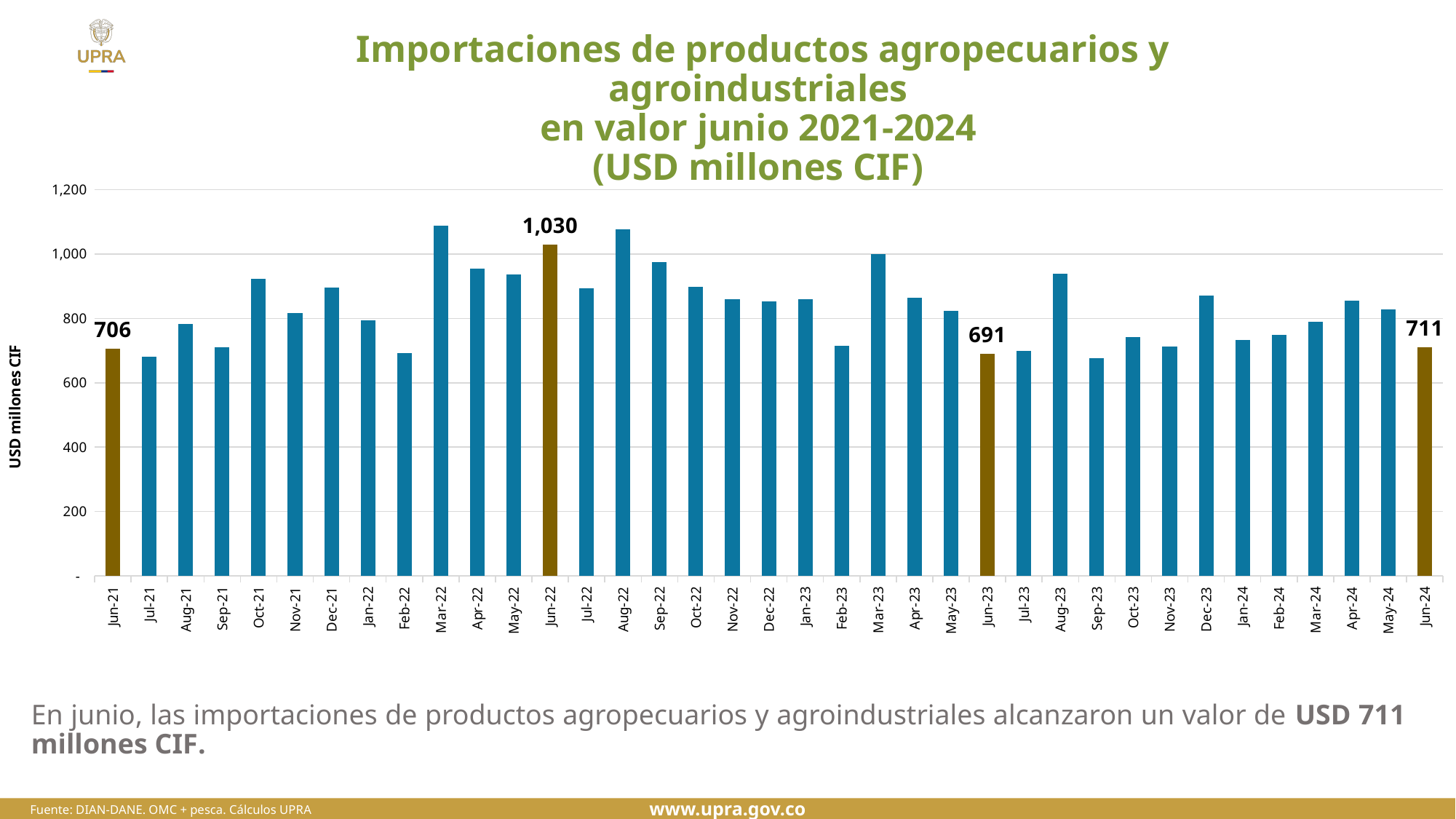
Is the value for Feb-22 greater or less than 800? less What kind of chart is shown on the slide? Bar chart What is the value for Jun-24? 711 How many monthly bars are plotted in the chart? 37 What is the value for Jun-22? 1,030 What is the difference between the values for Jun-24 and Jun-23? 20 Which is larger, the value for Jun-24 or the value for Jun-23? Jun-24 What is the value for Jun-23? 691 What is the value for Jun-21? 706 What is the difference between the values for Jun-22 and Jun-21? 324 What is the label on the vertical axis of the chart? USD millones CIF Is the value for Mar-22 greater or less than 1,000? greater